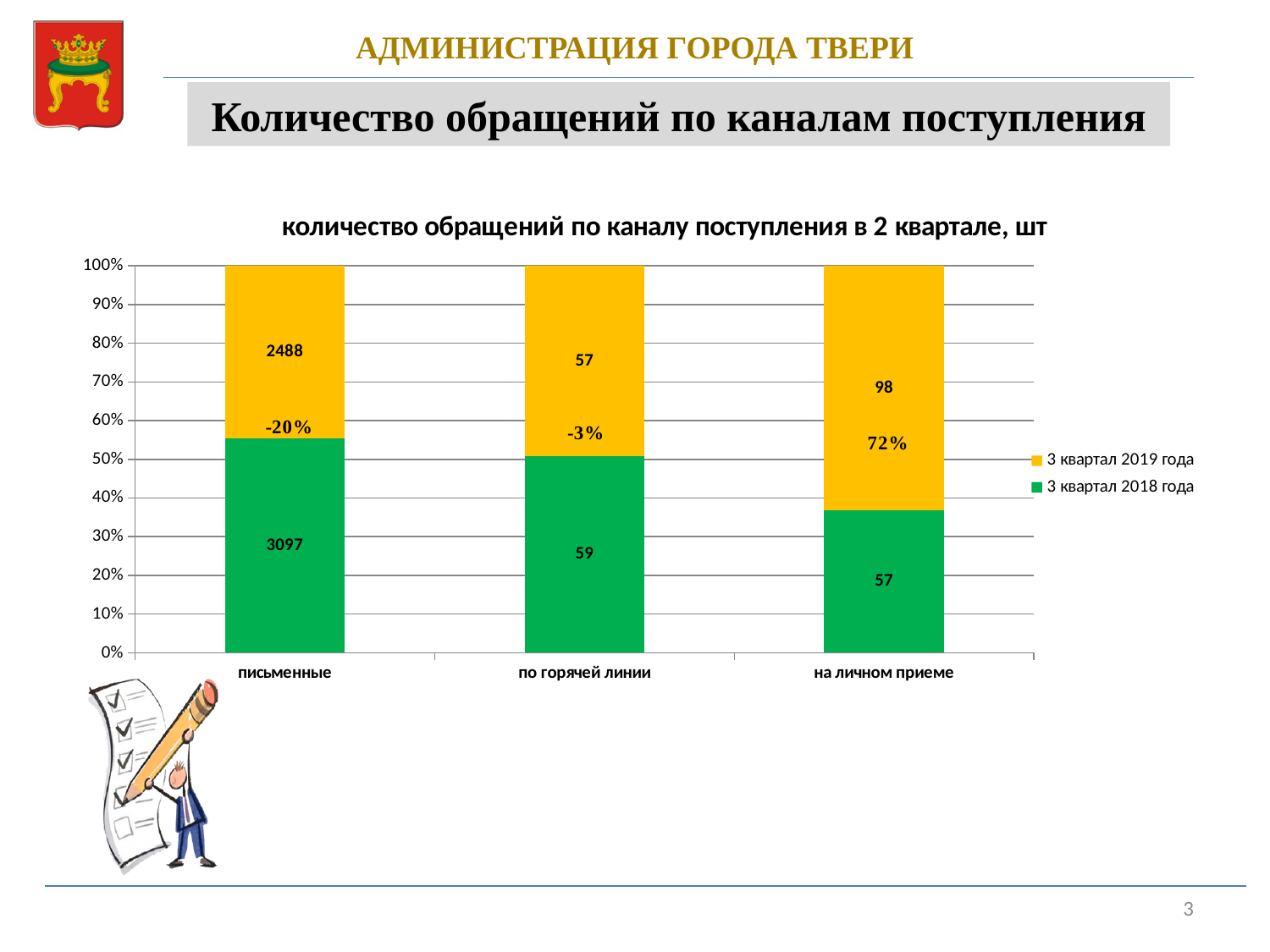
How many categories are shown on the x axis? 3 How many series does the legend list? 2 For на личном приеме, which series has the larger value: 3 квартал 2019 года or 3 квартал 2018 года? 3 квартал 2019 года Which category has the lowest value in the 3 квартал 2018 года series? на личном приеме What is the value for письменные in the 3 квартал 2019 года series? 2488 What is the value for по горячей линии in the 3 квартал 2018 года series? 59 What kind of chart is shown on the slide? stacked bar chart What is the difference between the 3 квартал 2018 года and 3 квартал 2019 года values for письменные? 609 What is the value for на личном приеме in the 3 квартал 2019 года series? 98 What percentage change is printed on the bar for на личном приеме? 72% Which category has the highest value in the 3 квартал 2019 года series? письменные What is the value for письменные in the 3 квартал 2018 года series? 3097